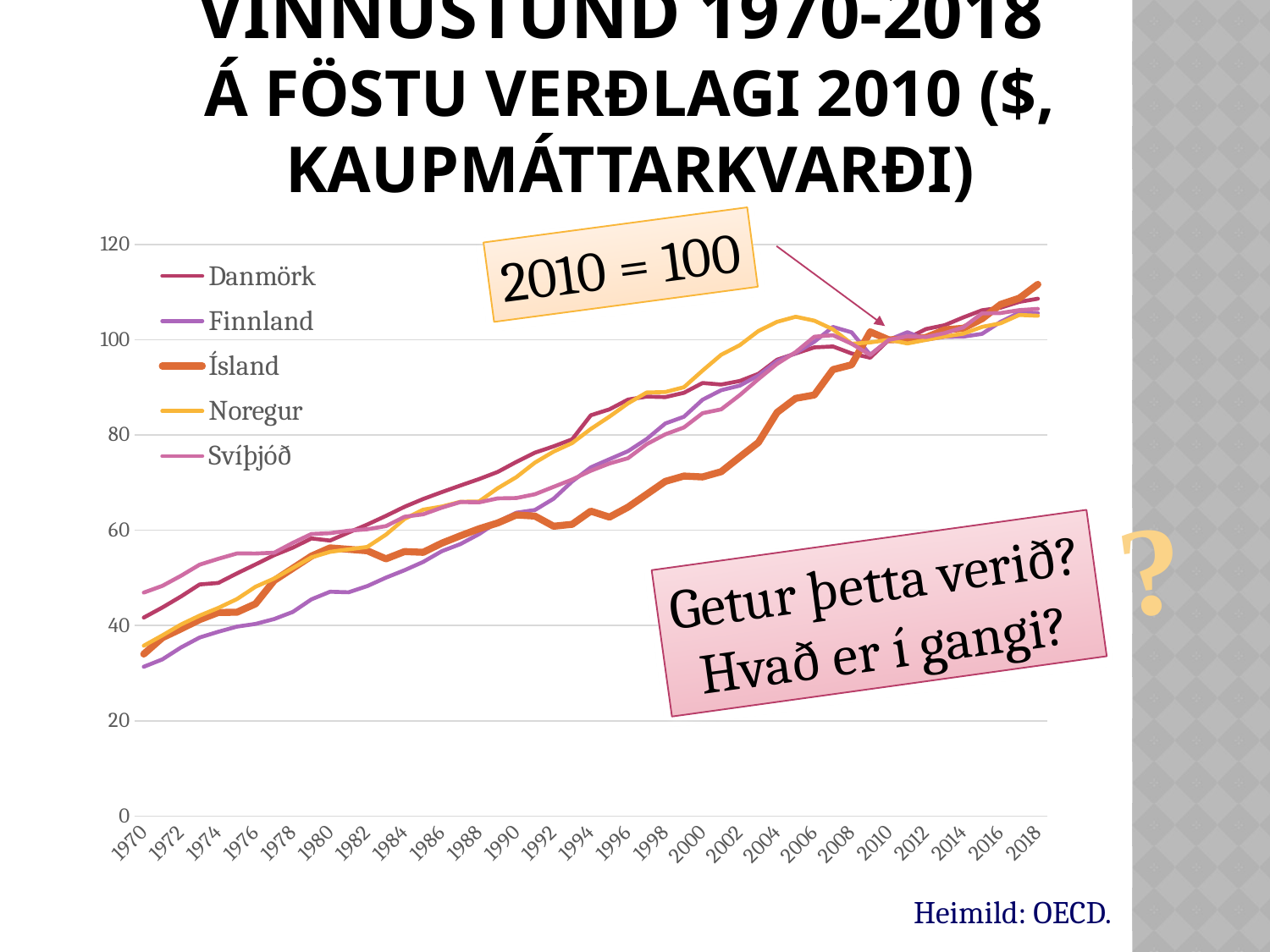
How many series does the chart legend list? 5 Which series has the highest value in 1970? Svíþjóð Which countries are listed in the chart legend? Danmörk, Finnland, Ísland, Noregur, Svíþjóð In 1994, which is larger: the value for Danmörk or the value for Ísland? Danmörk Is the value for Svíþjóð in 1970 greater or less than 40? greater Do the values for Ísland generally rise or fall from 1970 to 2018? rise What kind of chart is shown on the slide? line chart Is the value for Ísland in 1970 greater or less than 40? less According to the annotation on the chart, what index value do the series take in 2010? 100 What source is cited below the chart? OECD Is the value for Ísland in 2018 greater or less than 100? greater Which series has the lowest value in 1992? Ísland